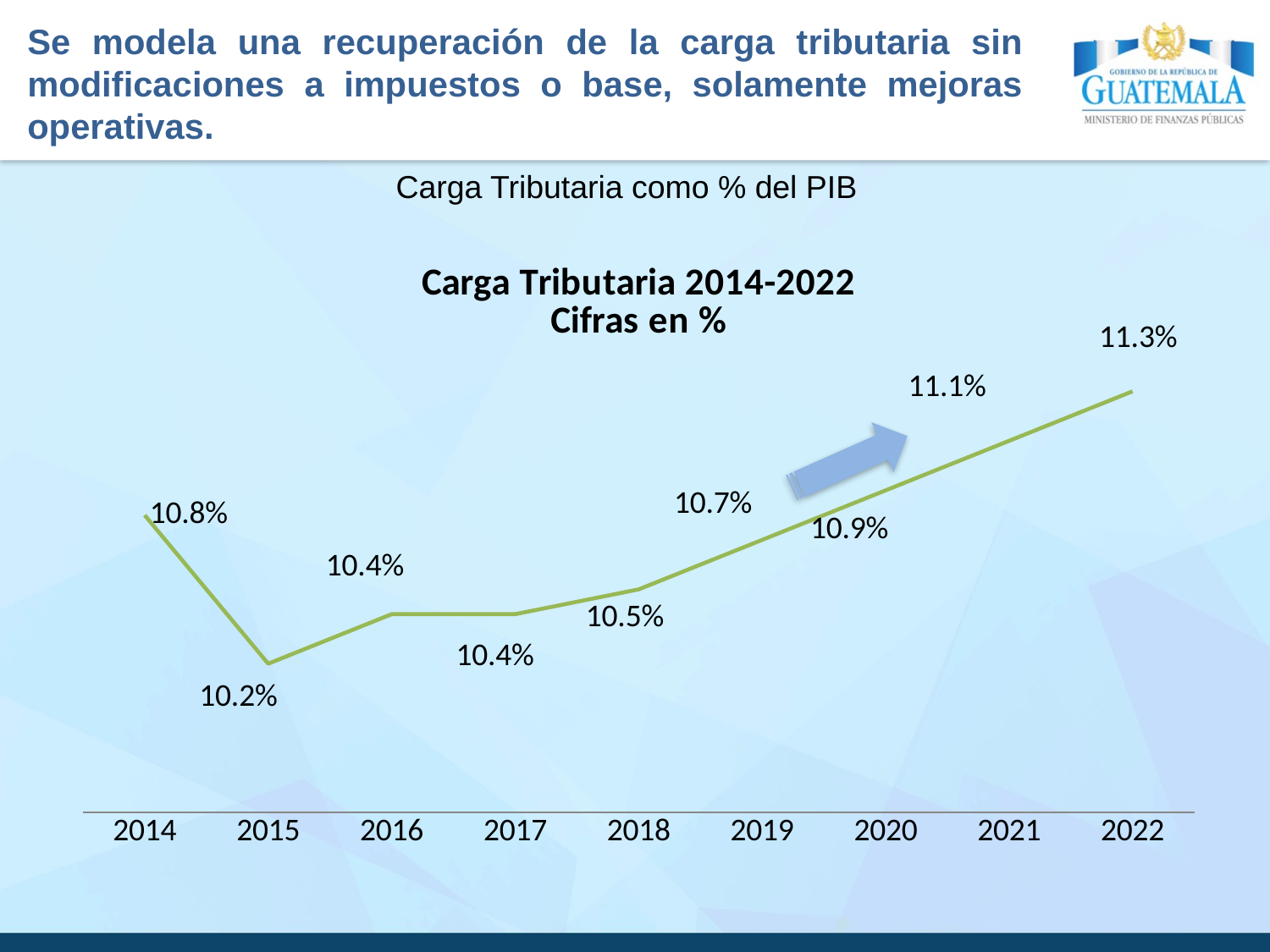
Which year has the lowest value? 2015 Which is larger, the value for 2020 or the value for 2018? 2020 Do the values rise or fall from 2015 to 2022? Rise What is the value for 2022? 11.3% How many years are plotted on the x axis? 9 What is the difference between the values for 2022 and 2014? 0.5% What is the value for 2019? 10.7% What kind of chart is this? Line chart Which year has the highest value? 2022 What is the value for 2015? 10.2% What is the value for 2014? 10.8% What is the difference between the values for 2014 and 2015? 0.6%